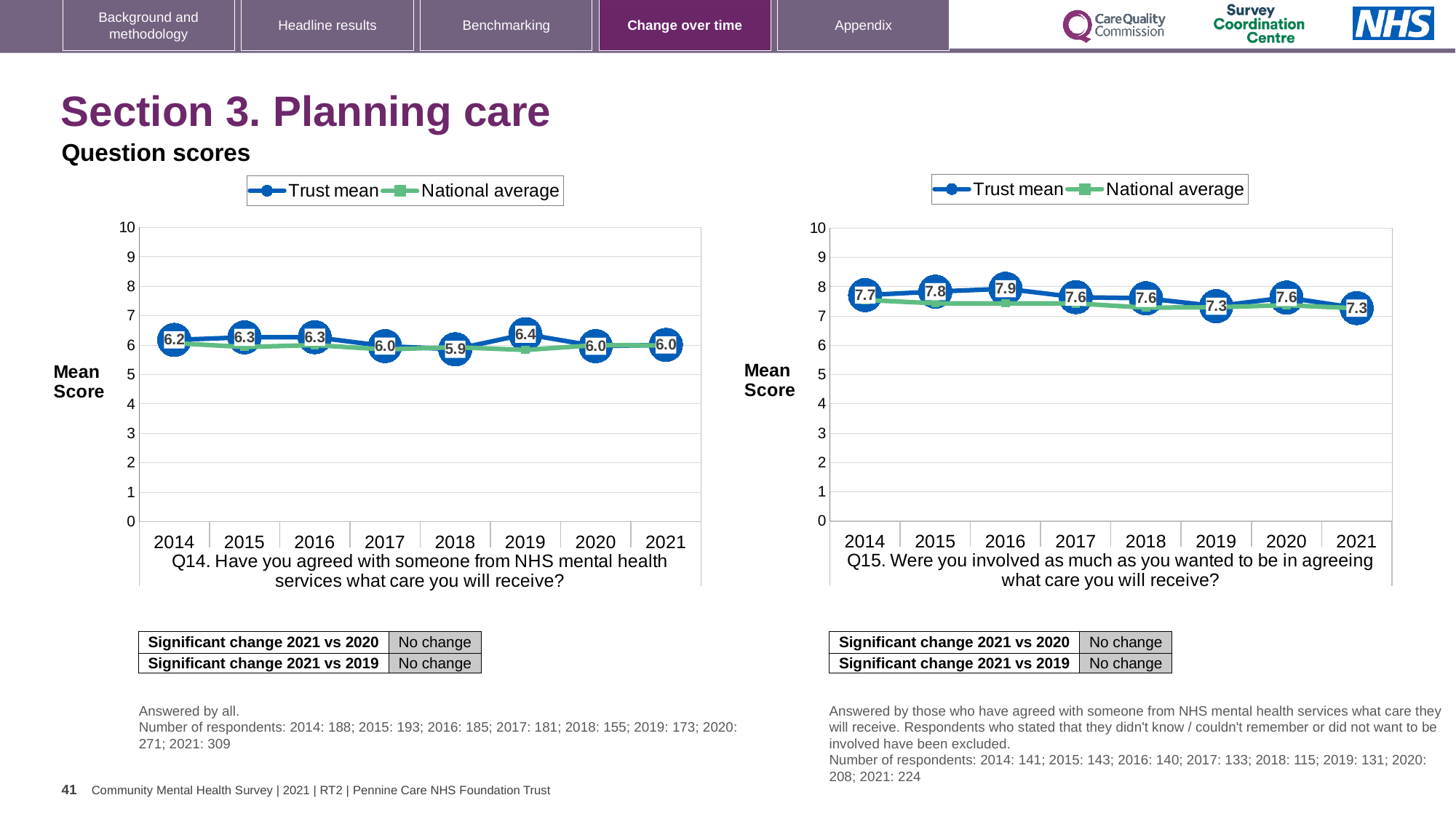
How many series does the legend of the Q15 chart (right) list? 2 On the Q15 chart (right), is the National average for 2021 greater or less than 8? less On the Q14 chart (left), what is the difference between the Trust mean in 2019 and in 2018? 0.5 On the Q15 chart (right), is the Trust mean for 2014 larger or smaller than the Trust mean for 2021? larger On the Q15 chart (right), what is the Trust mean for 2016? 7.9 On the Q14 chart (left), what is the Trust mean for 2018? 5.9 On the Q14 chart (left), which year has the highest Trust mean? 2019 On the Q14 chart (left), which year has the lowest Trust mean? 2018 On the Q15 chart (right), what is the Trust mean for 2021? 7.3 On the Q14 chart (left), what is the Trust mean for 2019? 6.4 How many years are shown on the x axis of the Q14 chart (left)? 8 On the Q15 chart (right), which year has the highest Trust mean? 2016